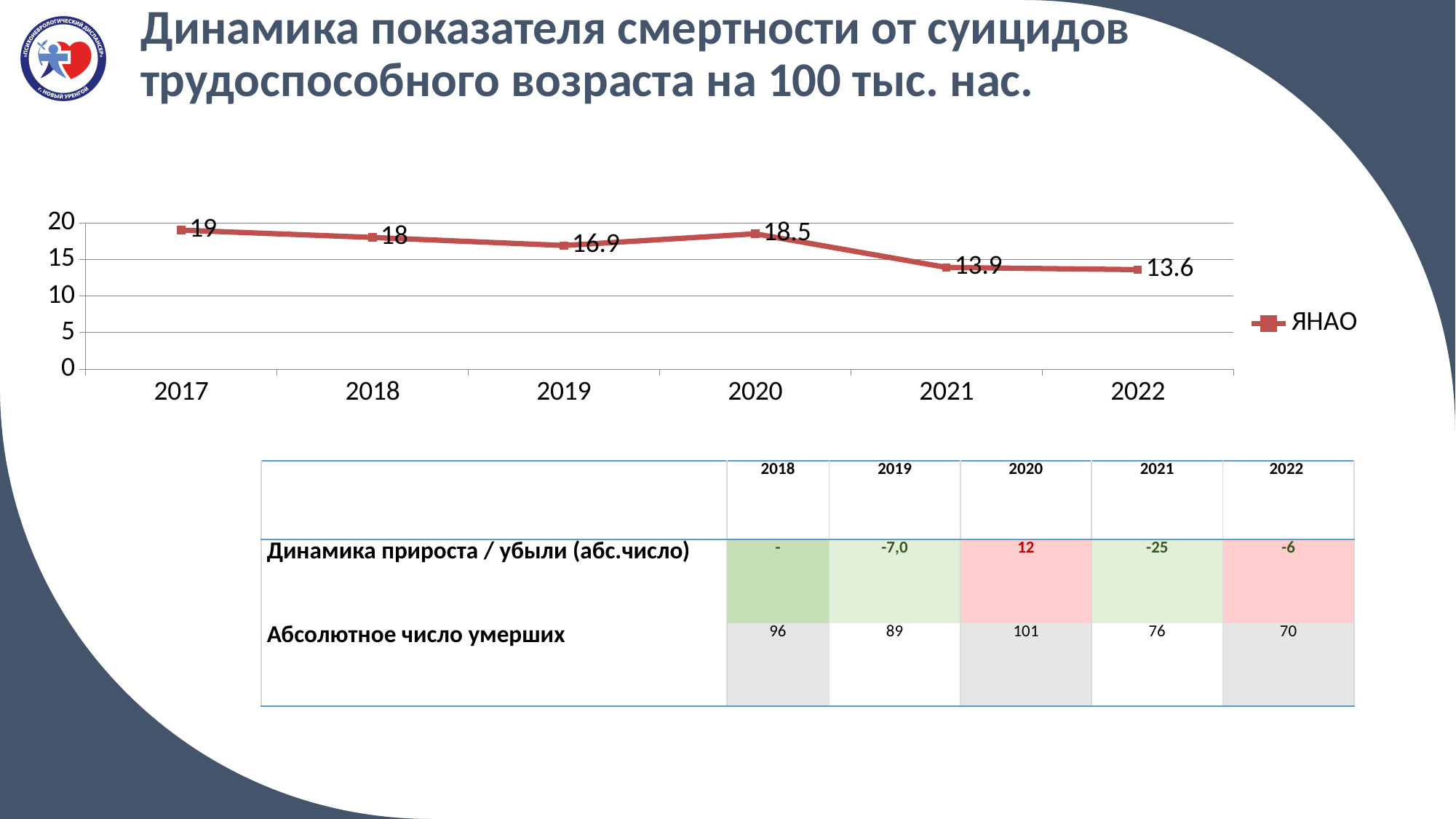
Is the value for 2021 in the line chart greater or less than 15? less What is the value for 2017 in the line chart? 19 What is the value for 2022 in the line chart? 13.6 What is the difference between the values for 2020 and 2021 in the line chart? 4.6 Which year has the lowest value in the line chart? 2022 What kind of chart is shown on the slide? line chart Which is larger in the line chart, the value for 2019 or the value for 2020? 2020 Which year has the highest value in the line chart? 2017 What series name does the legend of the line chart show? ЯНАО What is the difference between the values for 2017 and 2022 in the line chart? 5.4 How many years are plotted on the x axis of the line chart? 6 What is the value for 2020 in the line chart? 18.5